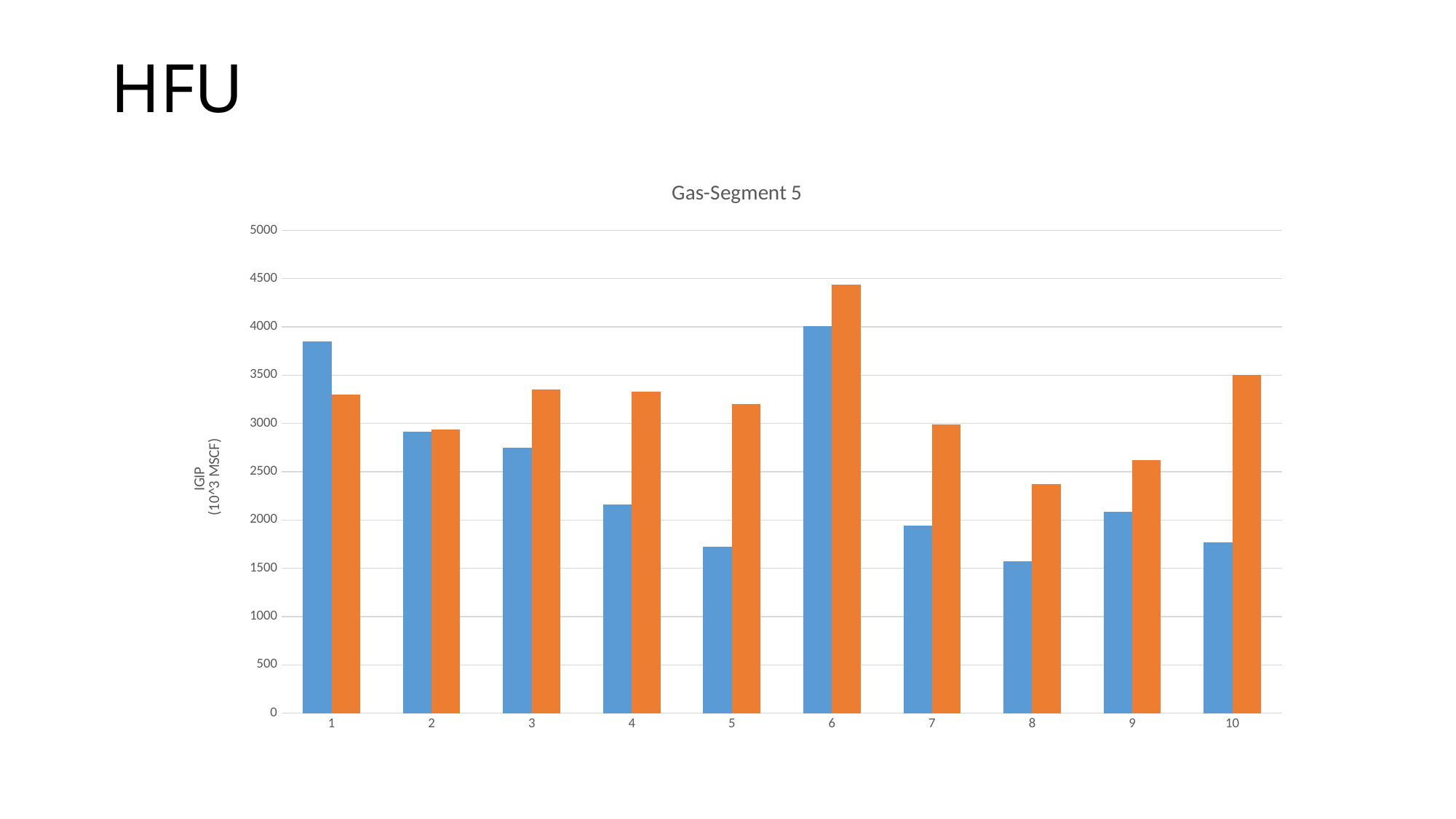
Which category has the lowest orange bar? 8 How many bars are plotted for each category? 2 Is the value of the blue bar for category 5 greater or less than 2000? less Is the value of the orange bar for category 6 greater or less than 4000? greater Which category has the highest orange bar? 6 Which category has the lowest blue bar? 8 How many categories are shown along the x axis? 10 Is the value of the blue bar for category 1 greater or less than 3500? greater What is the title of the chart? Gas-Segment 5 What kind of chart is shown on the slide? bar chart For category 10, which bar is larger, the blue bar or the orange bar? orange What is the label on the vertical axis of the chart? IGIP (10^3 MSCF)